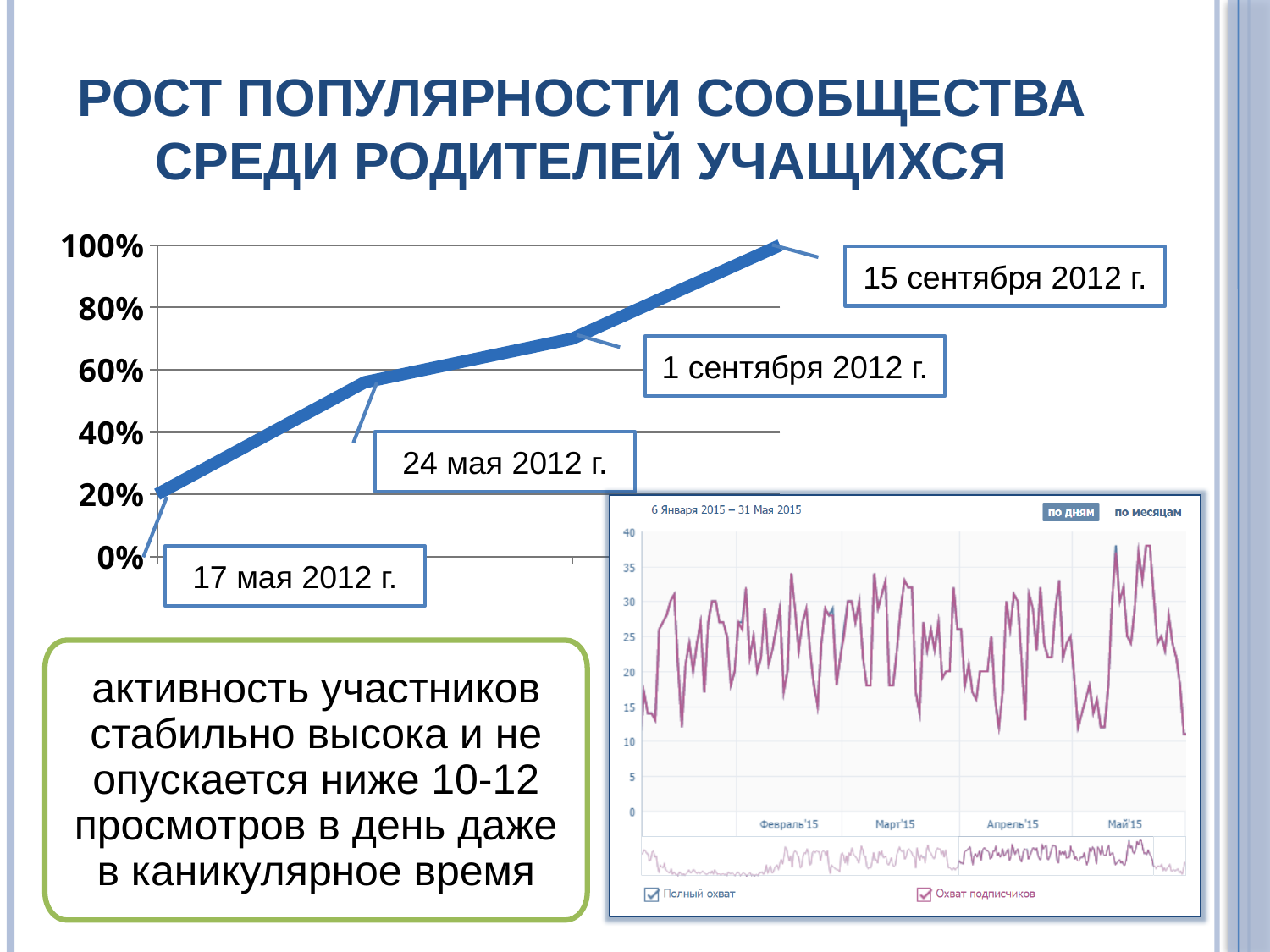
In the top chart, which is larger: the value for 24 мая 2012 г. or the value for 1 сентября 2012 г.? 1 сентября 2012 г. In the bottom-right chart, what date range is shown above the plot? 6 Января 2015 – 31 Мая 2015 In the top chart, what value does the line reach at 15 сентября 2012 г.? 100% In the top chart, how many dated points are labelled on the line? 4 In the top chart, is the value for 1 сентября 2012 г. greater or less than 80%? less In the bottom-right chart, how many series does the legend list? 2 What kind of chart is the top chart showing the growth of community popularity? line chart In the top chart, which labelled date has the lowest value? 17 мая 2012 г. In the top chart, which labelled date has the highest value? 15 сентября 2012 г. In the bottom-right chart, how many month labels appear on the x axis? 4 In the top chart, do the values rise or fall from 17 мая 2012 г. to 15 сентября 2012 г.? rise In the top chart, is the value for 24 мая 2012 г. greater or less than 40%? greater